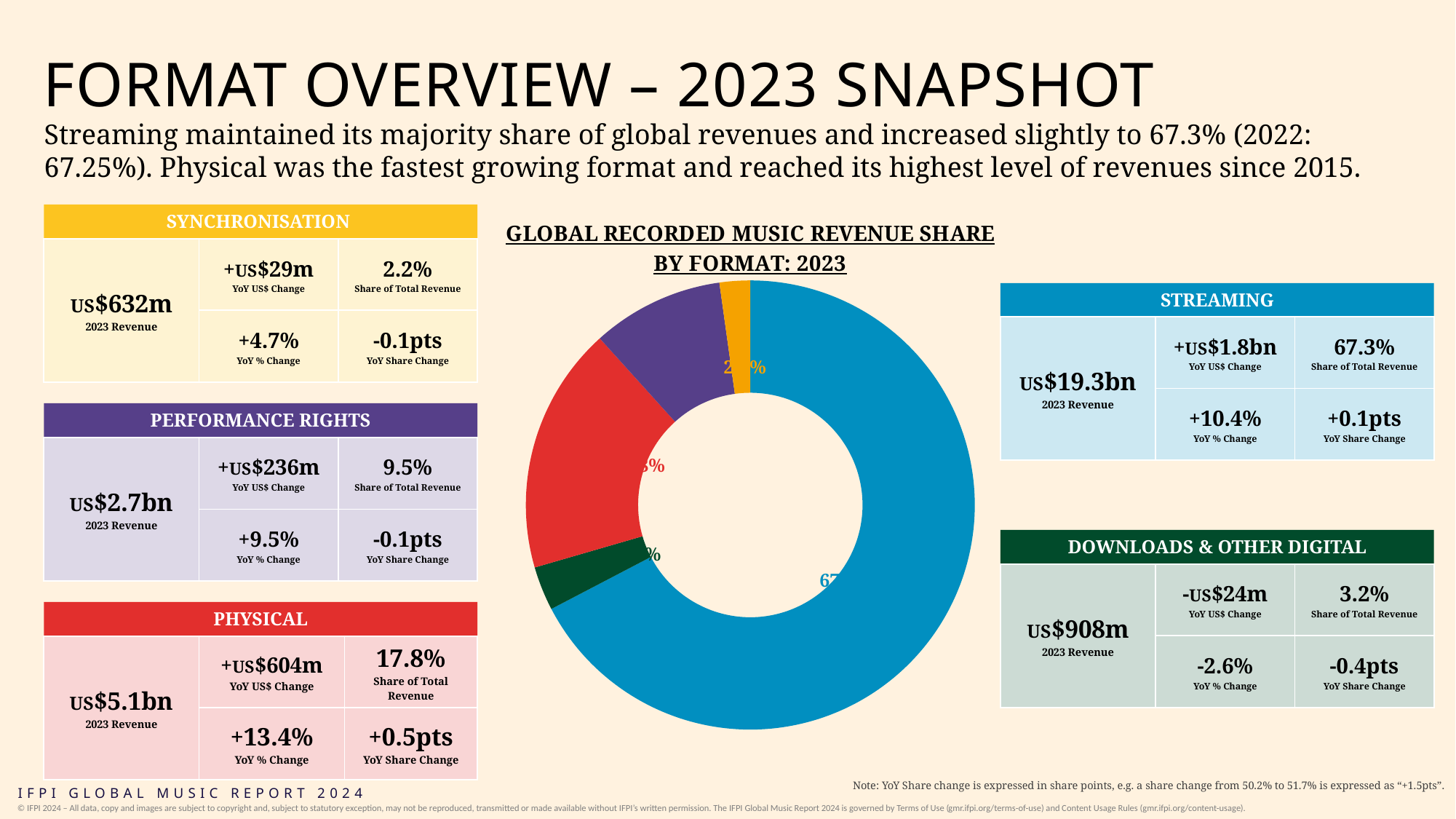
What share of total revenue does Physical account for in 2023? 17.8% What kind of chart is shown in the centre of the slide? Donut (pie) chart Which format has the largest share of global recorded music revenue in 2023? Streaming Which colour represents Streaming in the donut chart? Blue Which format has the smallest share of global recorded music revenue in 2023? Synchronisation What share of total revenue does Performance Rights account for in 2023? 9.5% What share of total revenue does Downloads & Other Digital account for in 2023? 3.2% Which has a larger share of 2023 revenue, Physical or Performance Rights? Physical How many format segments does the donut chart contain? 5 What is the title of the chart in the centre of the slide? Global Recorded Music Revenue Share by Format: 2023 What is the difference in share of total revenue between Streaming and Physical? 49.5 percentage points